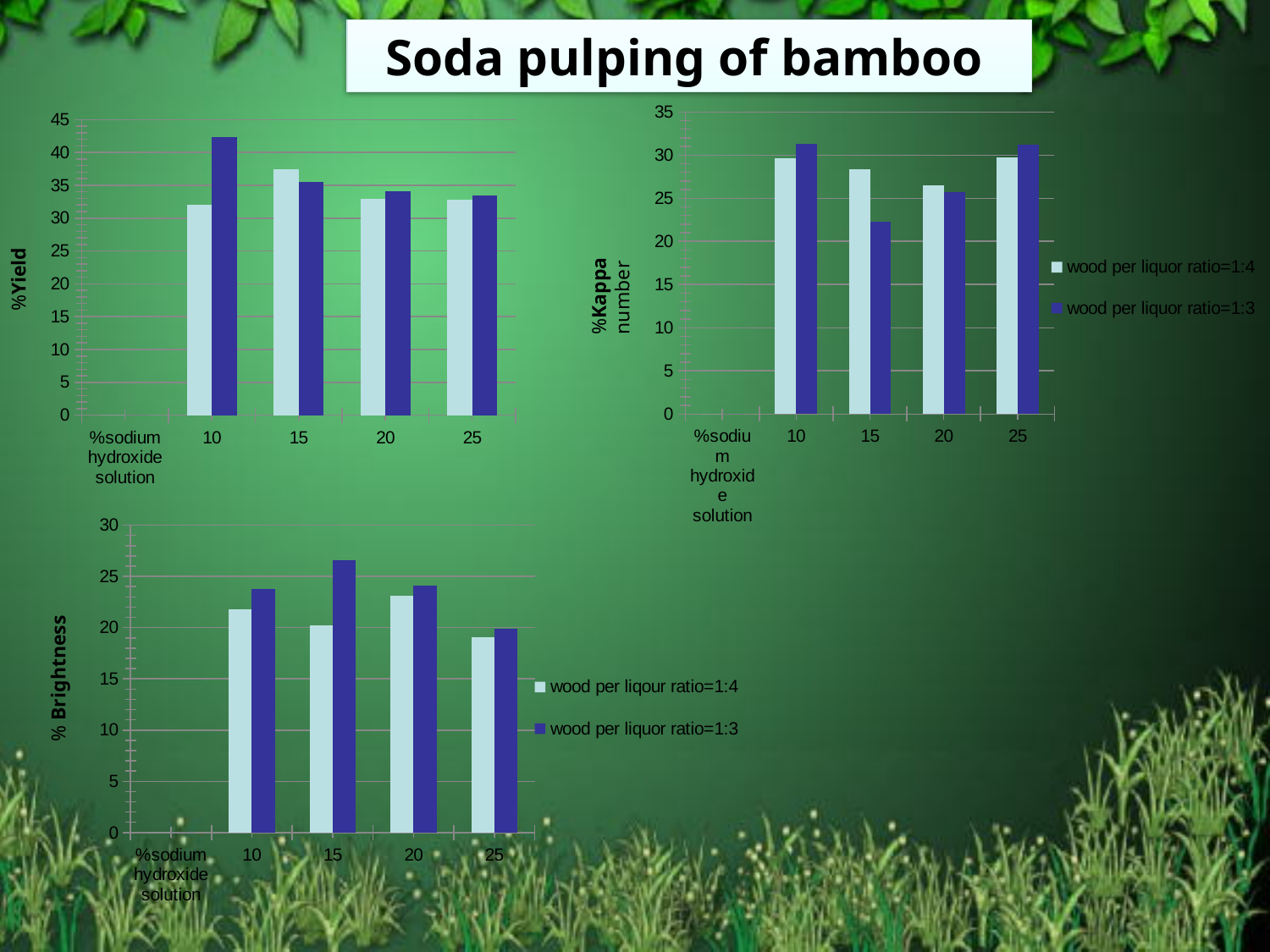
In the %Kappa number chart, at 10% sodium hydroxide, which series has the larger value: wood per liquor ratio=1:4 or wood per liquor ratio=1:3? wood per liquor ratio=1:3 In the % Brightness chart, which sodium hydroxide concentration has the highest bar for wood per liquor ratio=1:3? 15 In the %Kappa number chart, is the value for wood per liquor ratio=1:3 at 15% sodium hydroxide greater or less than 25? less In the %Kappa number chart, which sodium hydroxide concentration has the lowest bar for wood per liquor ratio=1:3? 15 In the %Yield chart, which sodium hydroxide concentration has the highest bar for wood per liquor ratio=1:3? 10 In the %Yield chart, do the values for wood per liquor ratio=1:3 rise or fall from 10 to 25% sodium hydroxide? fall In the %Yield chart, is the value for wood per liquor ratio=1:3 at 10% sodium hydroxide greater or less than 40? greater In the %Yield chart, is the value for wood per liquor ratio=1:4 at 10% sodium hydroxide greater or less than 35? less In the % Brightness chart, at 15% sodium hydroxide, which series has the larger value: wood per liqour ratio=1:4 or wood per liquor ratio=1:3? wood per liquor ratio=1:3 How many series does the legend of the %Kappa number chart list? 2 What kind of chart is the % Brightness chart? bar chart